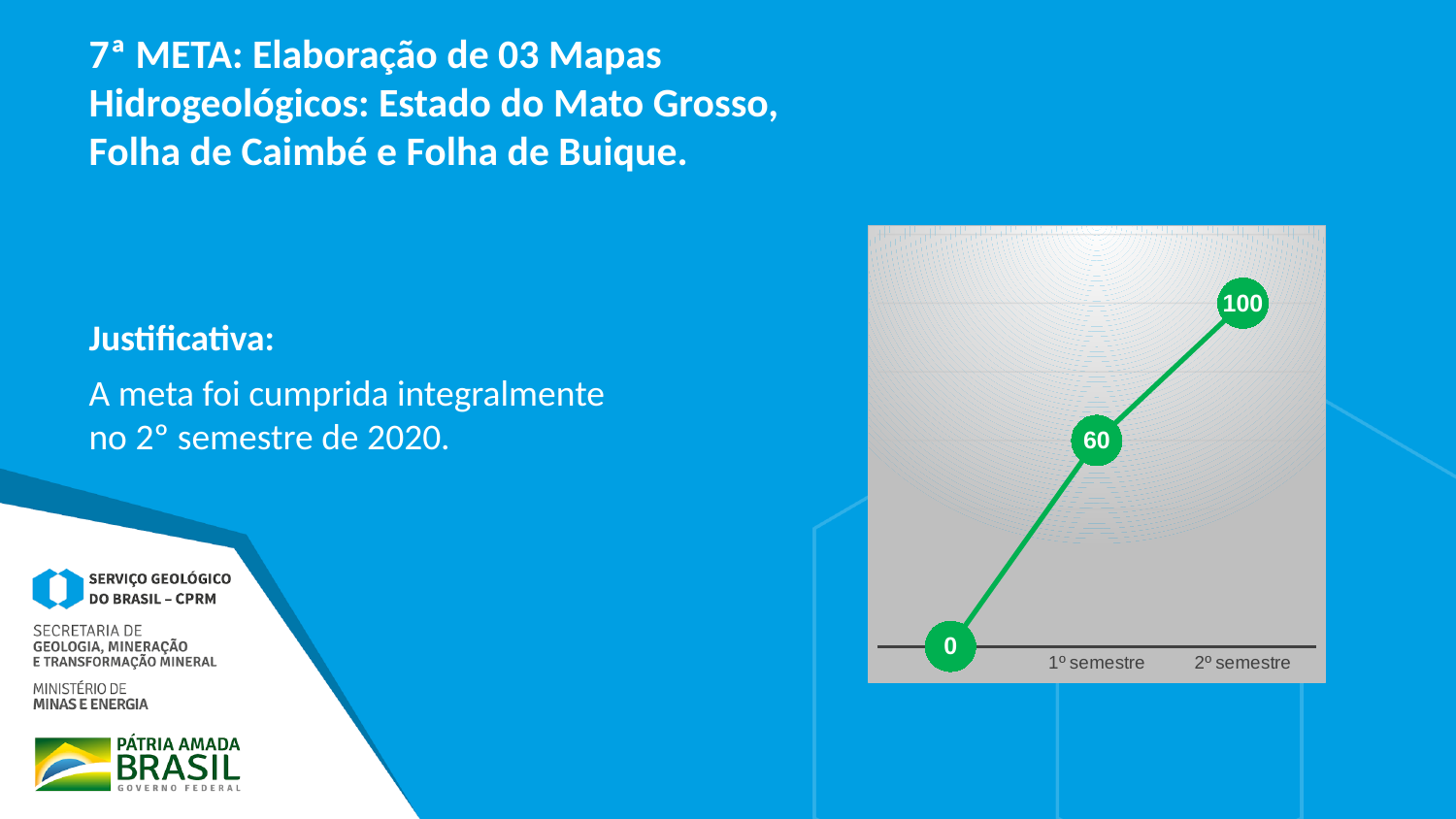
What is the value of the first (leftmost) point on the line? 0 What is the value plotted for 2º semestre? 100 How many category labels are shown on the x axis? 2 What colour is the line in the chart? green Which labelled semester has the higher value? 2º semestre How many data points are plotted on the line? 3 Is the value for 2º semestre larger or smaller than the value for 1º semestre? larger Which labelled semester has the lower value? 1º semestre Do the values rise or fall from left to right along the x axis? rise What is the difference between the values for 2º semestre and 1º semestre? 40 What is the value plotted for 1º semestre? 60 What kind of chart is shown on the slide? line chart